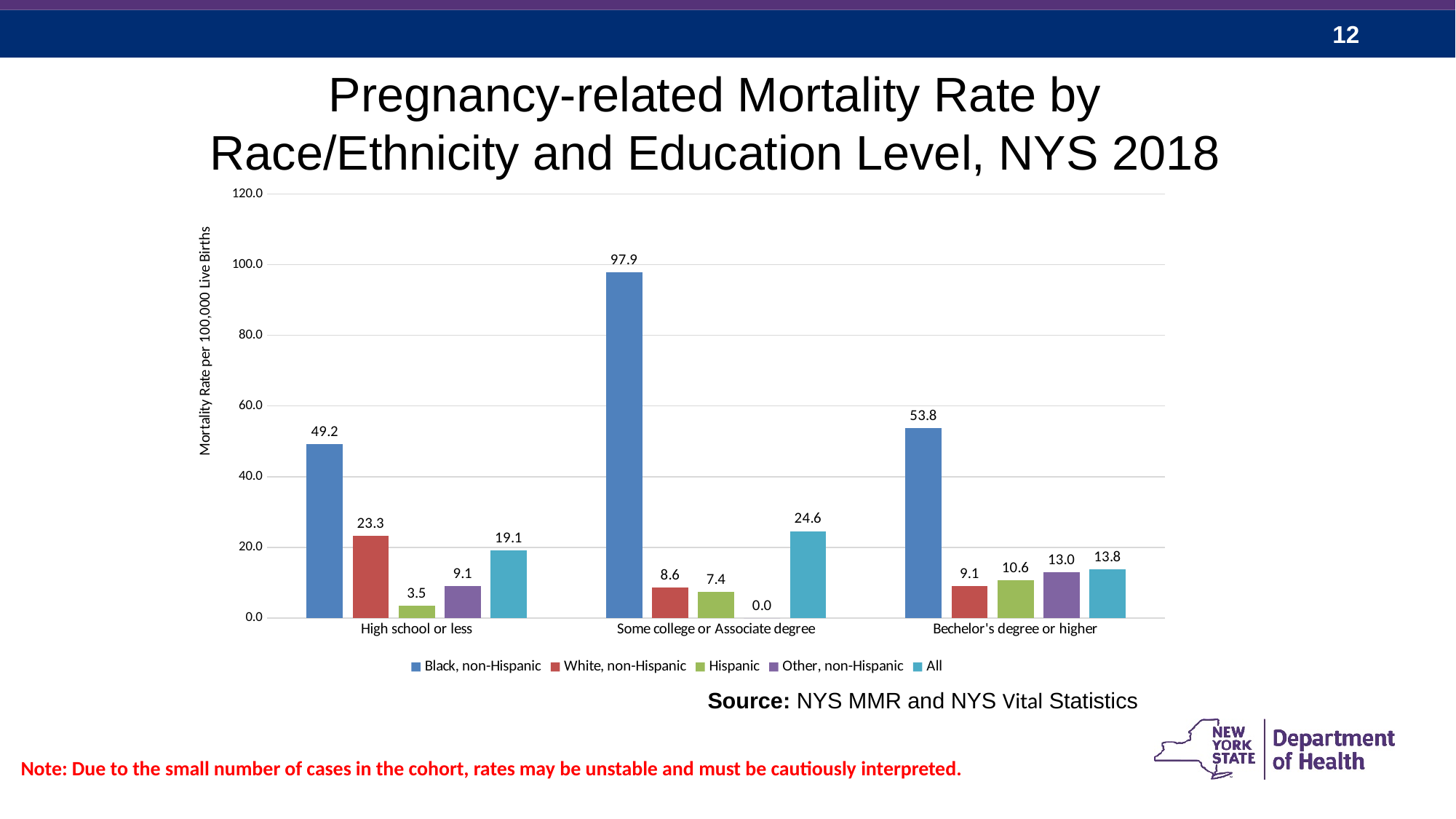
What kind of chart is shown on the slide? Bar chart How many education level categories are shown on the x axis? 3 What is the label of the y axis? Mortality Rate per 100,000 Live Births What is the mortality rate for Hispanic women with a high school education or less? 3.5 What is the mortality rate for the All group in the Bechelor's degree or higher category? 13.8 How many series does the legend list? 5 Is the Black, non-Hispanic mortality rate for Bechelor's degree or higher greater or less than 40.0? greater What is the mortality rate for Black, non-Hispanic women with some college or an Associate degree? 97.9 What is the difference between the Black, non-Hispanic and White, non-Hispanic mortality rates in the High school or less category? 25.9 Which education level has the highest mortality rate for Black, non-Hispanic women? Some college or Associate degree Which is larger: the All rate for High school or less or the All rate for Some college or Associate degree? Some college or Associate degree Which race/ethnicity group has the lowest mortality rate in the Some college or Associate degree category? Other, non-Hispanic